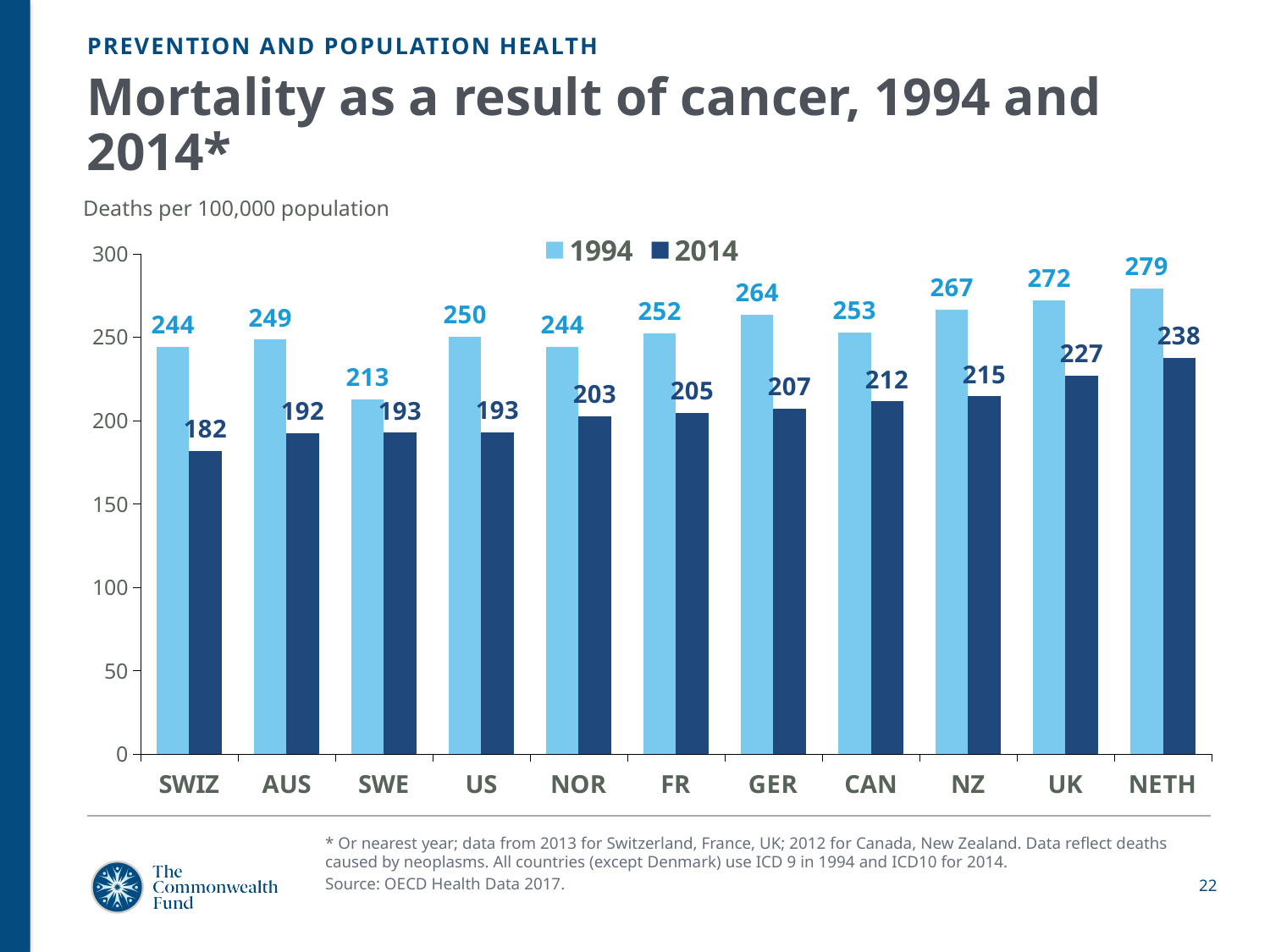
Which is larger: the 2014 cancer mortality rate for Canada (CAN) or for New Zealand (NZ)? NZ Which country had the lowest cancer mortality rate in 1994? SWE What was the cancer mortality rate for Switzerland (SWIZ) in 2014? 182 How many countries are shown on the chart? 11 What kind of chart is shown on the slide? Bar chart What was the cancer mortality rate for the Netherlands (NETH) in 1994? 279 Which country had the highest cancer mortality rate in 1994? NETH Which country had the lowest cancer mortality rate in 2014? SWIZ What unit is used for the values on the chart? Deaths per 100,000 population What was the cancer mortality rate for Germany (GER) in 2014? 207 What is the difference between the UK's cancer mortality rate in 1994 and in 2014? 45 How many series does the legend list? 2